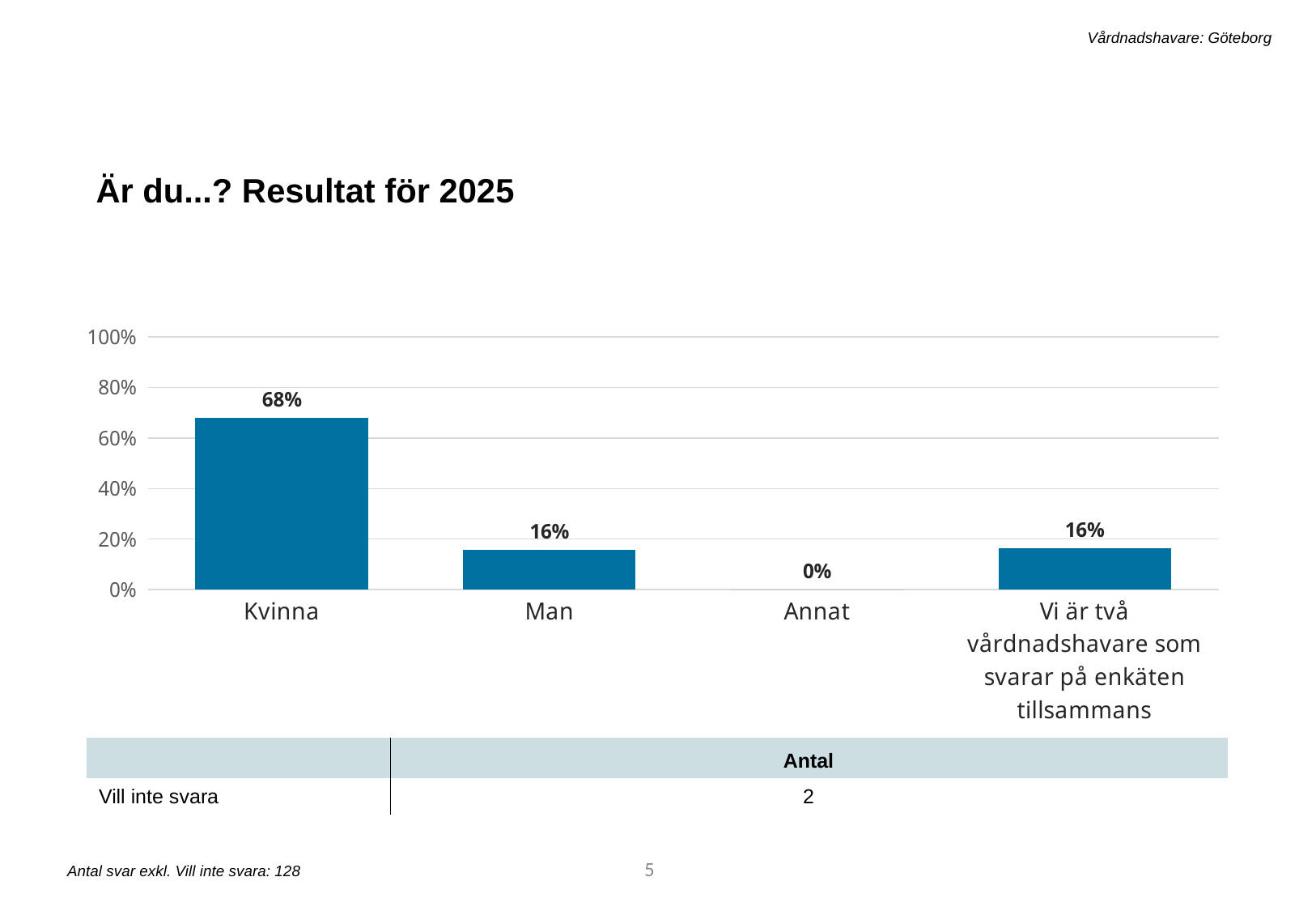
What is the value for Annat? 0% Which category has the highest value? Kvinna Is the value for Kvinna greater or less than 60%? greater What is the value for 'Vi är två vårdnadshavare som svarar på enkäten tillsammans'? 16% What is the title of the chart? Är du...? Resultat för 2025 Which is larger, the value for Kvinna or the value for Man? Kvinna What is the value for Kvinna? 68% What is the value for Man? 16% Which category has the lowest value? Annat How many categories are shown on the x axis? 4 What kind of chart is shown on the slide? Bar chart What is the difference between the values for Kvinna and Man? 52 percentage points